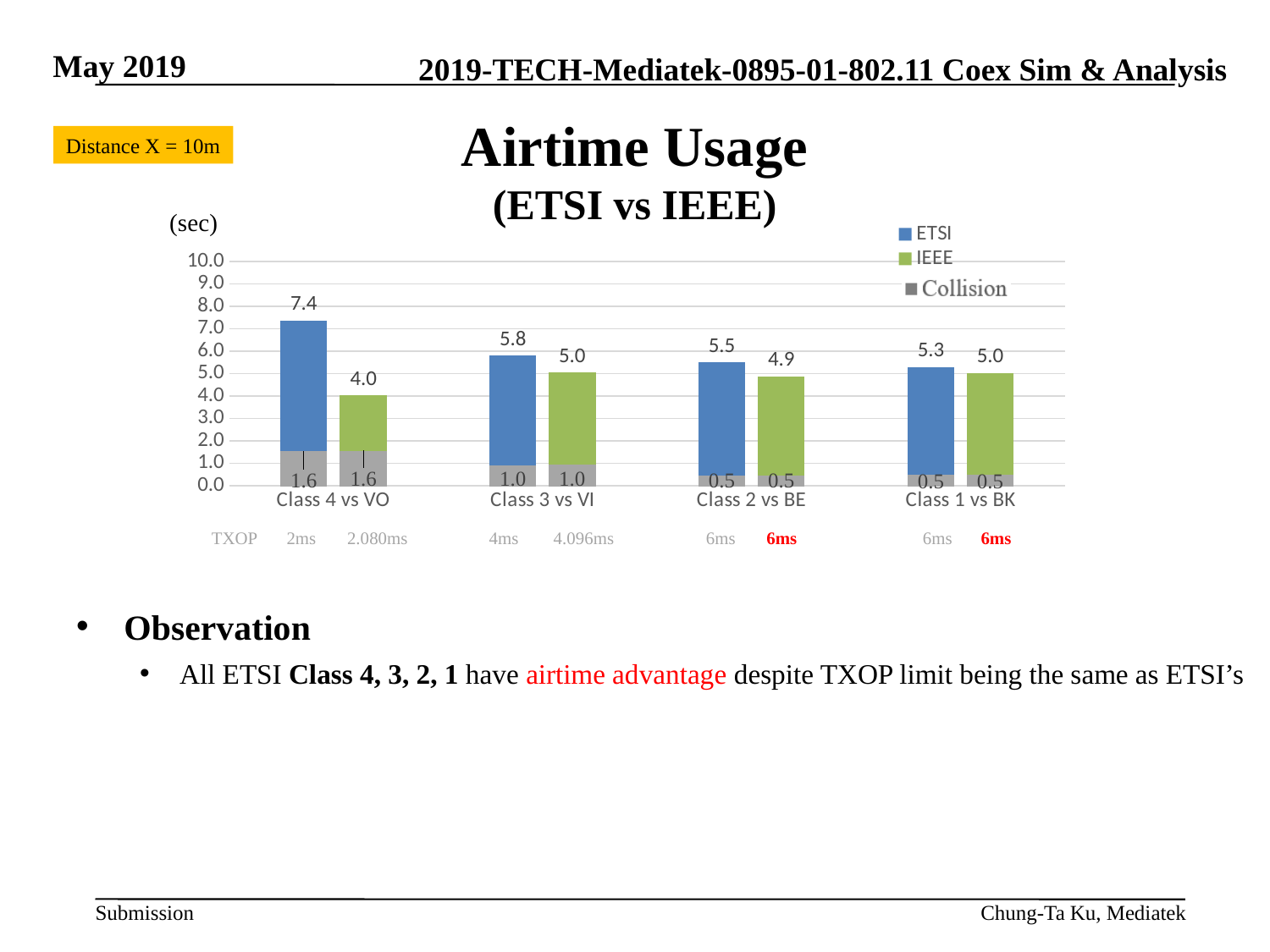
What is the ETSI airtime value for Class 1 vs BK? 5.3 What is the difference between the ETSI and IEEE airtime values for Class 4 vs VO? 3.4 What is the IEEE airtime value for Class 2 vs BE? 4.9 How many series does the chart legend list? 3 Which category has the highest ETSI airtime value? Class 4 vs VO What is the ETSI airtime value for Class 4 vs VO? 7.4 Which is larger for Class 3 vs VI, the ETSI value or the IEEE value? ETSI How many categories are shown on the x axis of the chart? 4 Which category has the lowest IEEE airtime value? Class 4 vs VO Is the ETSI value for Class 2 vs BE greater or less than 5.0? greater What is the IEEE airtime value for Class 3 vs VI? 5.0 What type of chart is shown on the slide? Bar chart